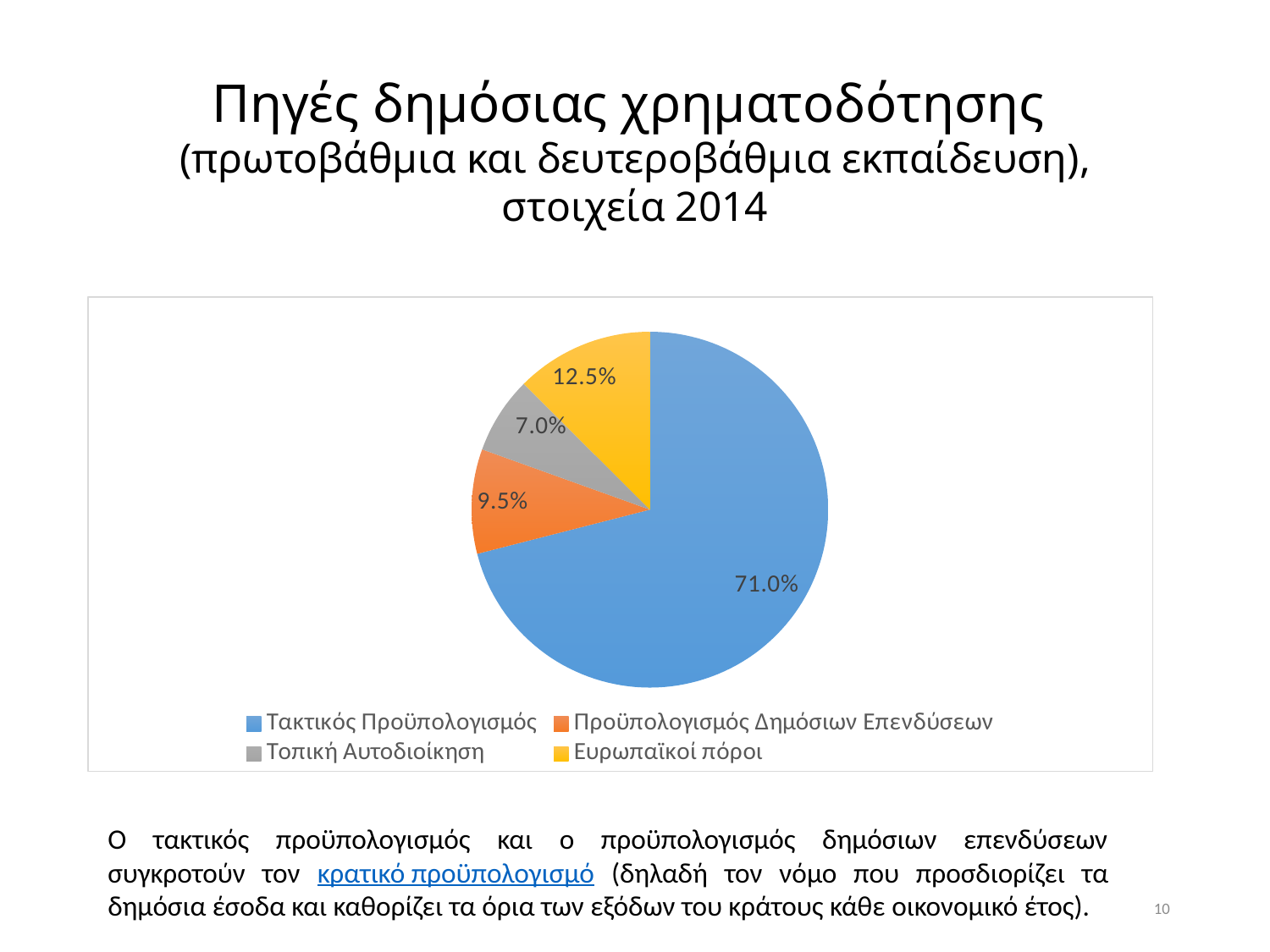
Which funding source has the largest share of the pie? Τακτικός Προϋπολογισμός What kind of chart is shown on the slide? Pie chart Which colour represents Ευρωπαϊκοί πόροι in the pie chart? Yellow Which funding source has the smallest share of the pie? Τοπική Αυτοδιοίκηση What is the difference in percentage points between Ευρωπαϊκοί πόροι and Προϋπολογισμός Δημόσιων Επενδύσεων? 3.0 percentage points How many slices does the pie chart have? 4 What percentage is shown for Τοπική Αυτοδιοίκηση? 7.0% Which is larger, the share for Ευρωπαϊκοί πόροι or the share for Τοπική Αυτοδιοίκηση? Ευρωπαϊκοί πόροι What is the combined share of Τακτικός Προϋπολογισμός and Προϋπολογισμός Δημόσιων Επενδύσεων? 80.5% What share of the pie does Τακτικός Προϋπολογισμός represent? 71.0% What percentage is shown for Προϋπολογισμός Δημόσιων Επενδύσεων? 9.5% What percentage is shown for Ευρωπαϊκοί πόροι? 12.5%